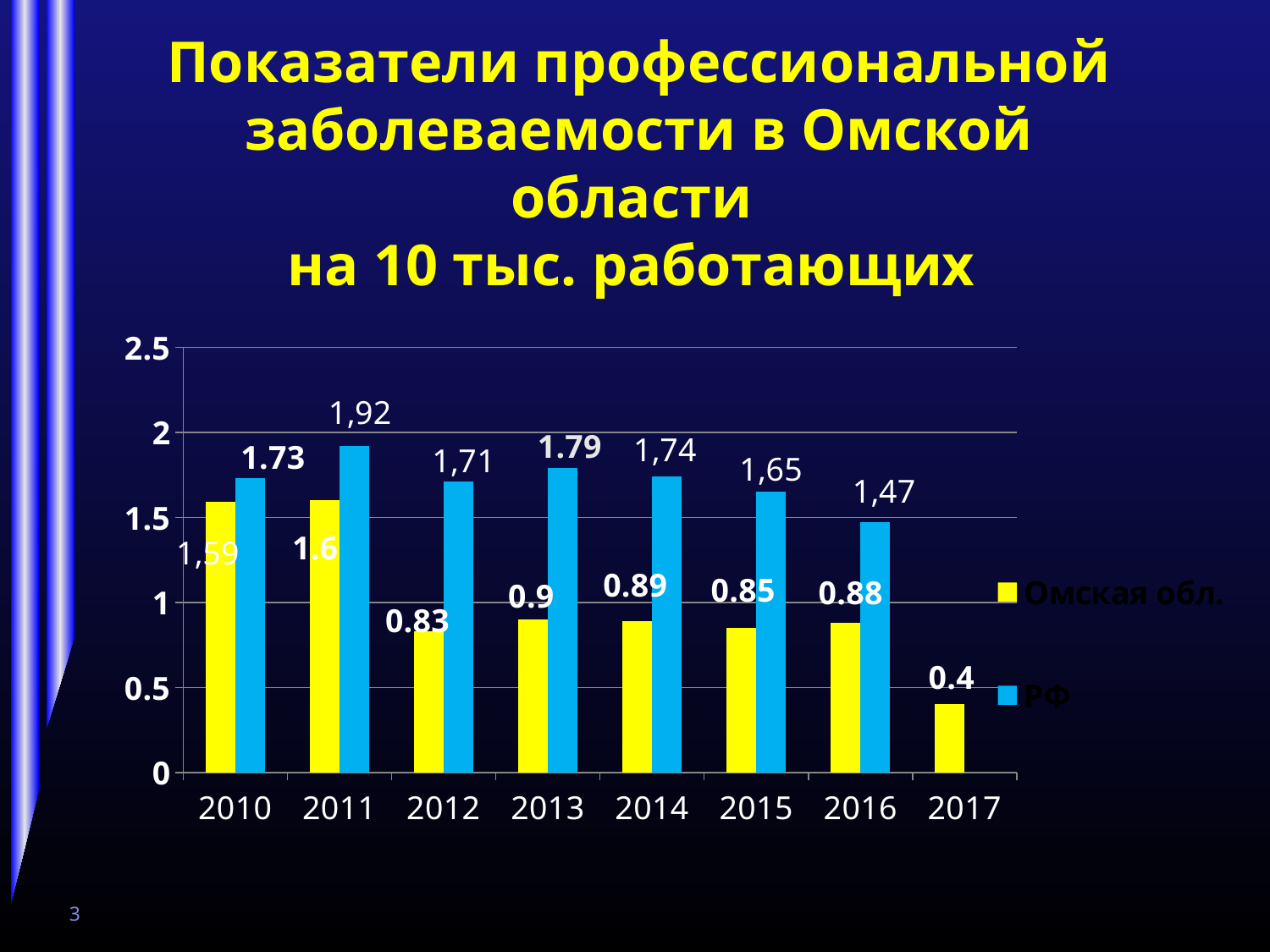
In which year is the РФ value highest? 2011 What is the difference between the Омская обл. values for 2013 and 2017? 0.5 Is the value for РФ in 2015 greater or less than 1.5? greater In which year is the Омская обл. value lowest? 2017 What is the value for Омская обл. in 2017? 0.4 How many years are shown on the x axis? 8 How many series does the legend list? 2 What kind of chart is shown on the slide? bar chart What is the value for РФ in 2011? 1,92 What is the value for Омская обл. in 2012? 0.83 Which is larger in 2014: the value for Омская обл. or for РФ? РФ What is the value for РФ in 2016? 1,47